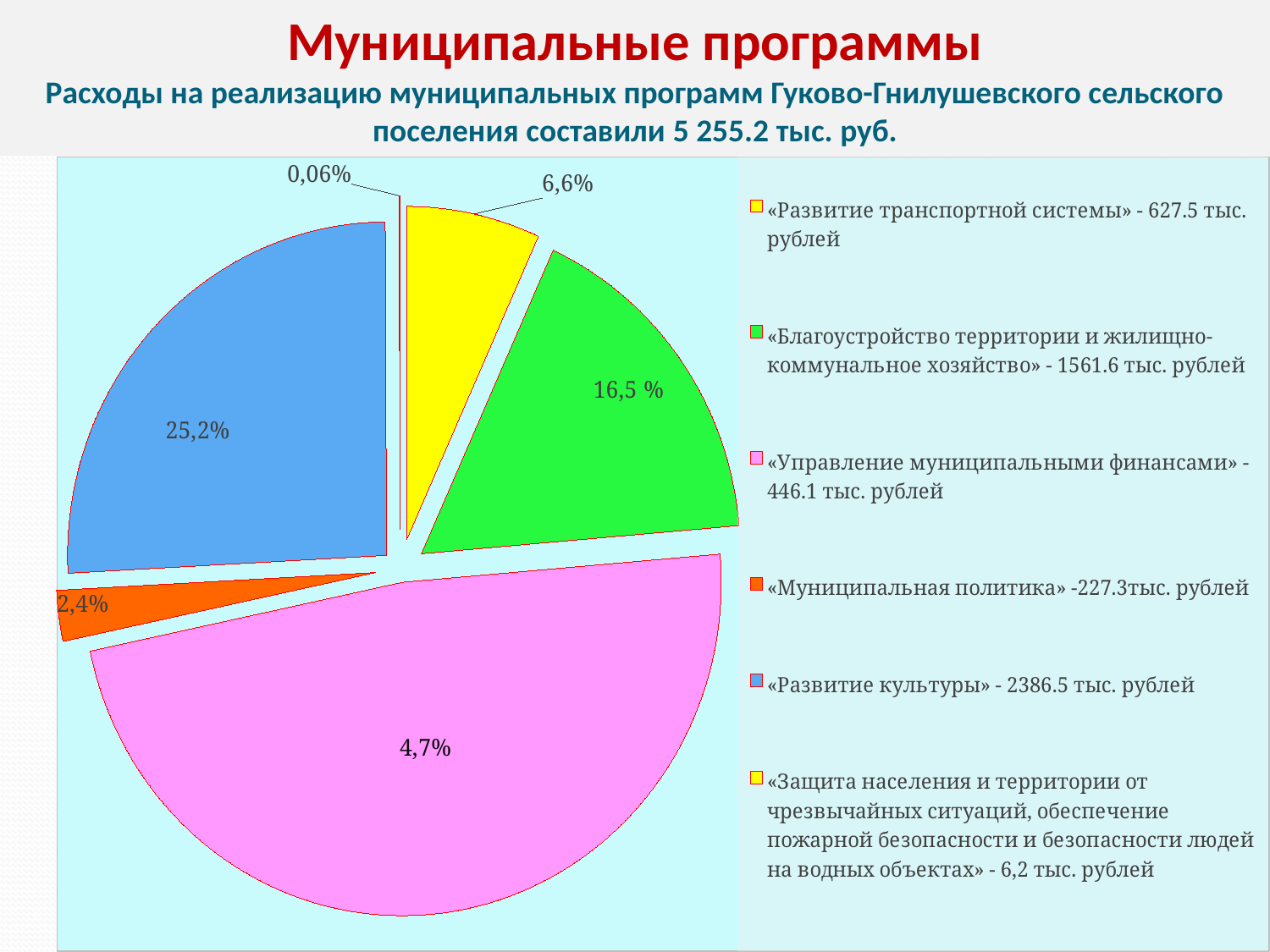
Which legend entry has the smallest amount in тыс. рублей? «Защита населения и территории от чрезвычайных ситуаций, обеспечение пожарной безопасности и безопасности людей на водных объектах» How many entries does the legend of the pie chart list? 6 According to the legend, what amount is given for «Развитие культуры»? 2386.5 тыс. рублей What kind of chart is shown on the slide? pie chart What total expenditure on municipal programs is stated in the slide subtitle? 5 255.2 тыс. руб. Which legend amount is larger: «Развитие транспортной системы» or «Управление муниципальными финансами»? «Развитие транспортной системы» Which legend entry has the largest amount in тыс. рублей? «Развитие культуры» How many slices does the pie chart have? 6 By how much does the legend amount for «Развитие культуры» exceed that for «Благоустройство территории и жилищно-коммунальное хозяйство»? 824.9 тыс. рублей What percentage label is shown on the blue slice of the pie chart? 25,2% According to the legend, what amount is given for «Благоустройство территории и жилищно-коммунальное хозяйство»? 1561.6 тыс. рублей According to the legend, what amount is given for «Муниципальная политика»? 227.3 тыс. рублей